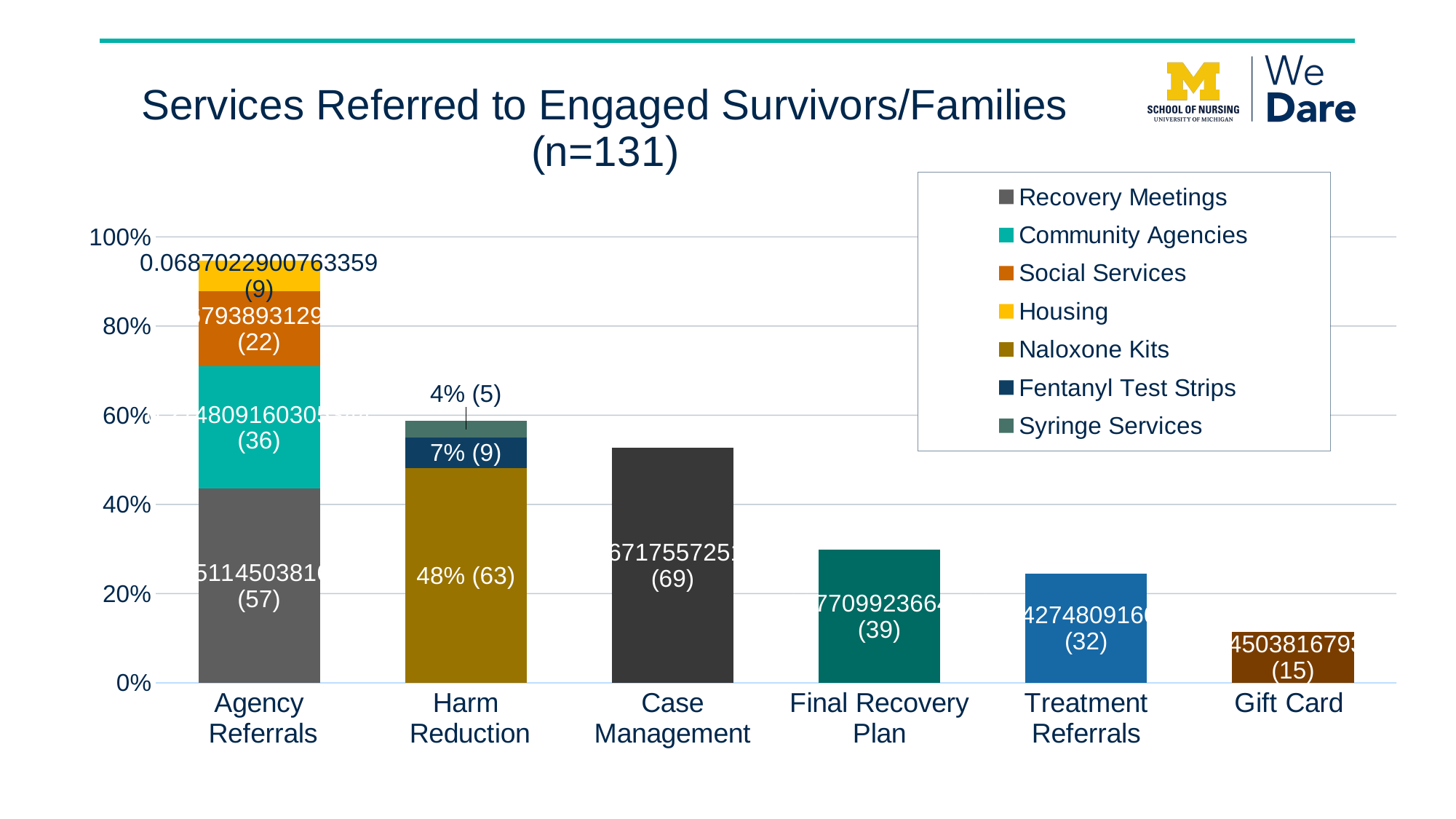
Which category has the shortest bar? Gift Card What percentage and count are labelled for Fentanyl Test Strips in the Harm Reduction bar? 7% (9) How many series does the legend list? 7 What count is shown in parentheses for the Case Management bar? 69 What count is shown in parentheses for the Gift Card bar? 15 What kind of chart is shown on the slide? Stacked bar chart What percentage and count are labelled for Naloxone Kits in the Harm Reduction bar? 48% (63) Which category has the tallest bar overall? Agency Referrals Is the value for Case Management greater or less than 40%? greater What count is shown in parentheses for the Recovery Meetings segment of the Agency Referrals bar? 57 What is the difference in percentage between Fentanyl Test Strips and Syringe Services in the Harm Reduction bar? 3% How many categories are shown along the x axis? 6